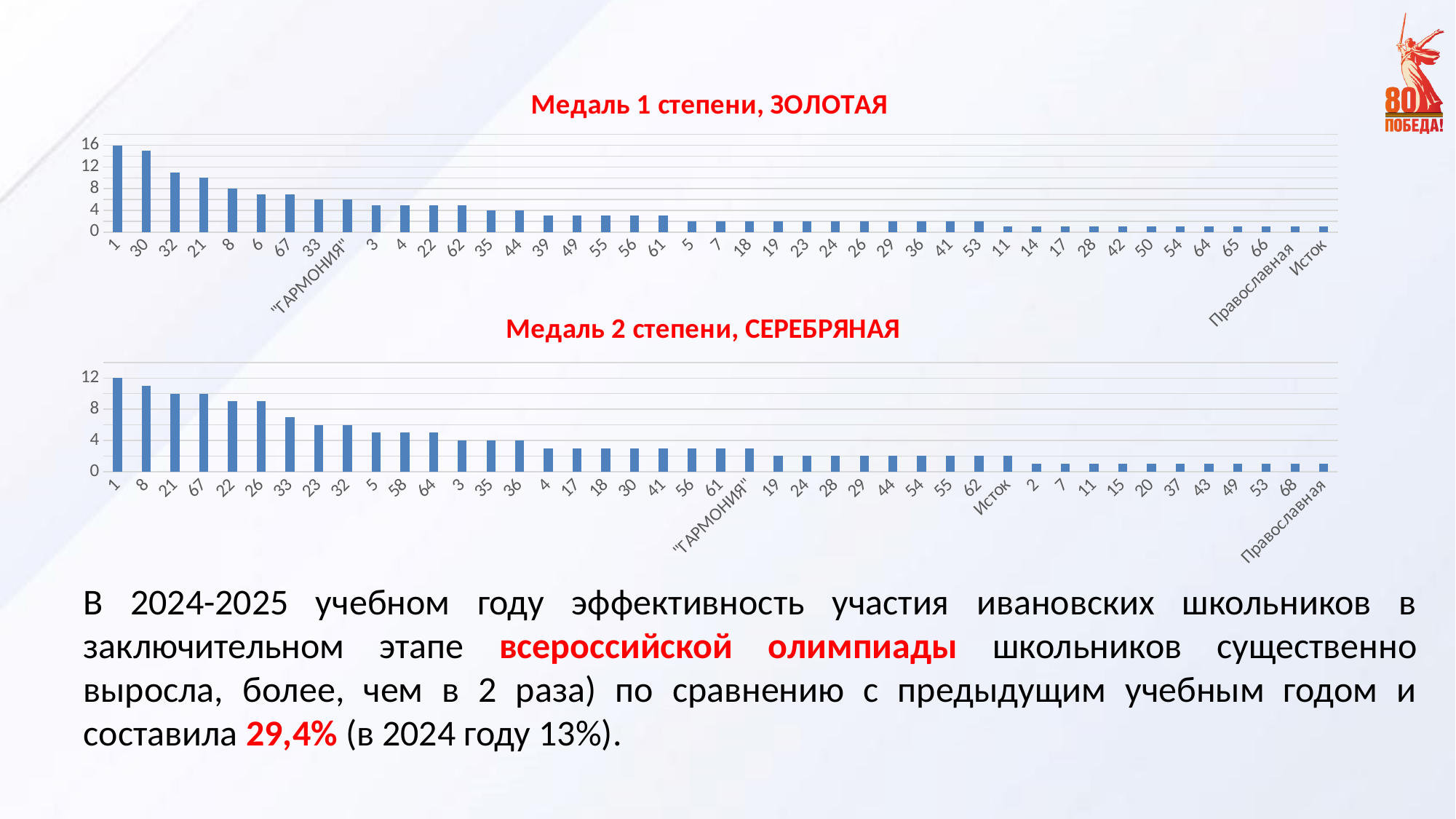
In the chart 'Медаль 2 степени, СЕРЕБРЯНАЯ', what is the value for category 1? 12 In the chart 'Медаль 2 степени, СЕРЕБРЯНАЯ', is the value for category 33 greater or less than 8? less In the chart 'Медаль 1 степени, ЗОЛОТАЯ', which is larger: the value for category 1 or for category 8? 1 In the chart 'Медаль 1 степени, ЗОЛОТАЯ', is the value for 'Исток' greater or less than 4? less What is the title of the upper chart on the slide? Медаль 1 степени, ЗОЛОТАЯ In the chart 'Медаль 2 степени, СЕРЕБРЯНАЯ', do the values rise or fall from left to right along the x axis? Fall In the chart 'Медаль 2 степени, СЕРЕБРЯНАЯ', which category has the highest value? 1 In the chart 'Медаль 2 степени, СЕРЕБРЯНАЯ', which is larger: the value for category 8 or for category 5? 8 In the chart 'Медаль 1 степени, ЗОЛОТАЯ', is the value for category 30 greater or less than 12? greater In the chart 'Медаль 1 степени, ЗОЛОТАЯ', which category has the highest value? 1 In the chart 'Медаль 1 степени, ЗОЛОТАЯ', what is the value for category 1? 16 What kind of chart is used for 'Медаль 1 степени, ЗОЛОТАЯ'? Bar chart